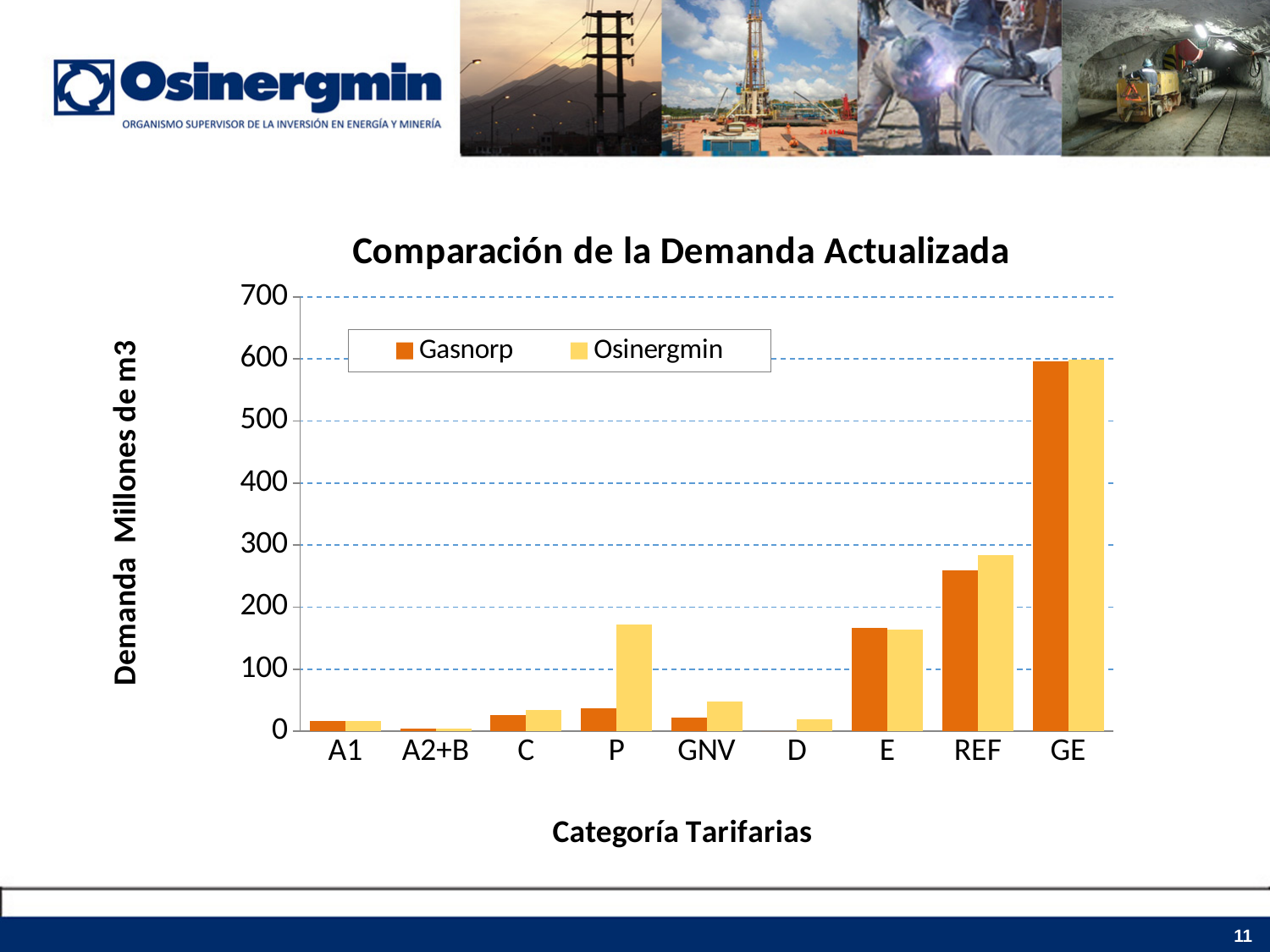
Is the Osinergmin value for REF greater or less than 300? less For category REF, which series has the larger value, Gasnorp or Osinergmin? Osinergmin What is the title of the chart? Comparación de la Demanda Actualizada Is the Osinergmin value for P greater or less than 100? greater Which category has the highest Gasnorp value? GE What kind of chart is shown on the slide? bar chart How many series does the legend list? 2 Which category has the highest Osinergmin value? GE For category P, which series has the larger value, Gasnorp or Osinergmin? Osinergmin Which category has the lowest Osinergmin value? A2+B How many tariff categories are shown on the x axis? 9 Is the Gasnorp value for GE greater or less than 500? greater